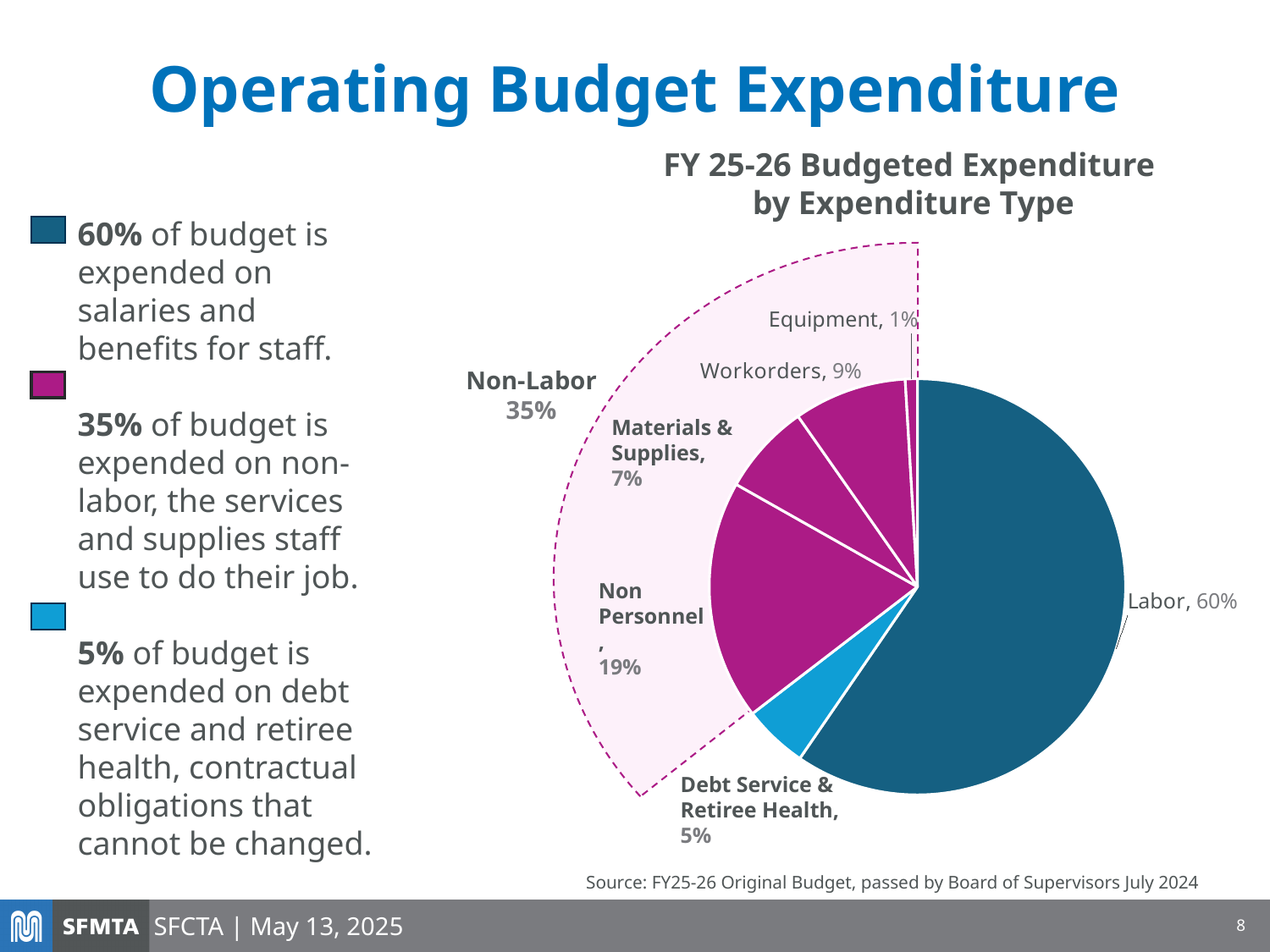
What share of the pie is Non Personnel? 19% Which slice of the pie is the smallest? Equipment Which slice of the pie is the largest? Labor What share of the pie is Labor? 60% What kind of chart is shown on the slide? pie chart What is the difference between the Labor share and the Non Personnel share? 41% What share of the pie is Debt Service & Retiree Health? 5% What is the title of the chart? FY 25-26 Budgeted Expenditure by Expenditure Type How many slices does the pie chart have? 6